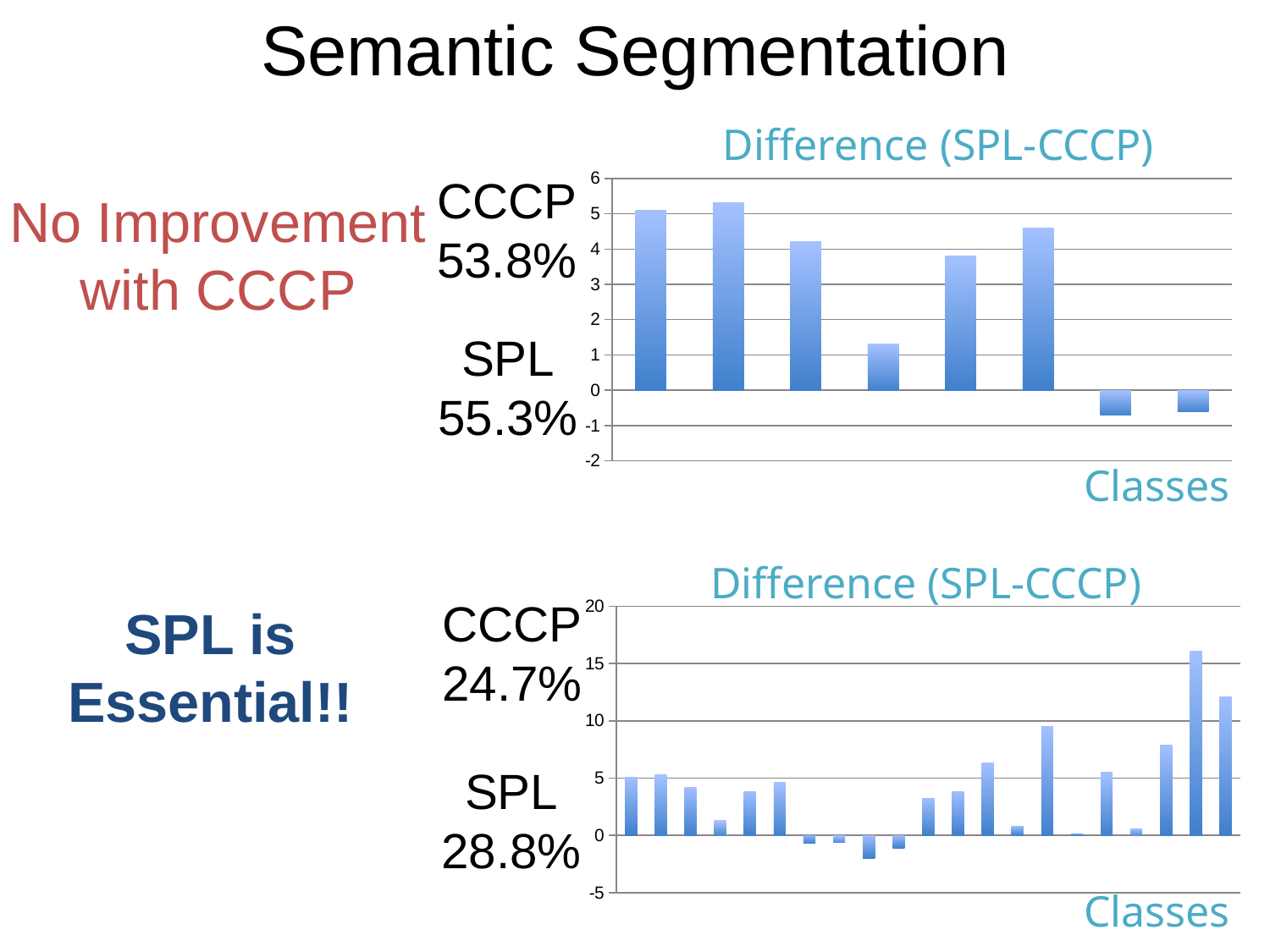
In the bottom chart, which bar is the highest? the second bar from the right In the top chart, is the value of the second bar from the left greater or less than 5? greater In the top chart, is the value of the fourth bar from the left greater or less than 2? less In the bottom chart, how many bars have a negative value? 4 What label appears under the x axis of the top chart? Classes What is the title of the bottom chart? Difference (SPL-CCCP) What type of chart is the top chart on the slide? bar chart How many bars are plotted in the bottom chart? 21 In the top chart, is the value of the first bar larger or smaller than the value of the fourth bar? larger In the top chart, how many bars have a negative value? 2 In the bottom chart, is the value of the tallest bar greater or less than 15? greater